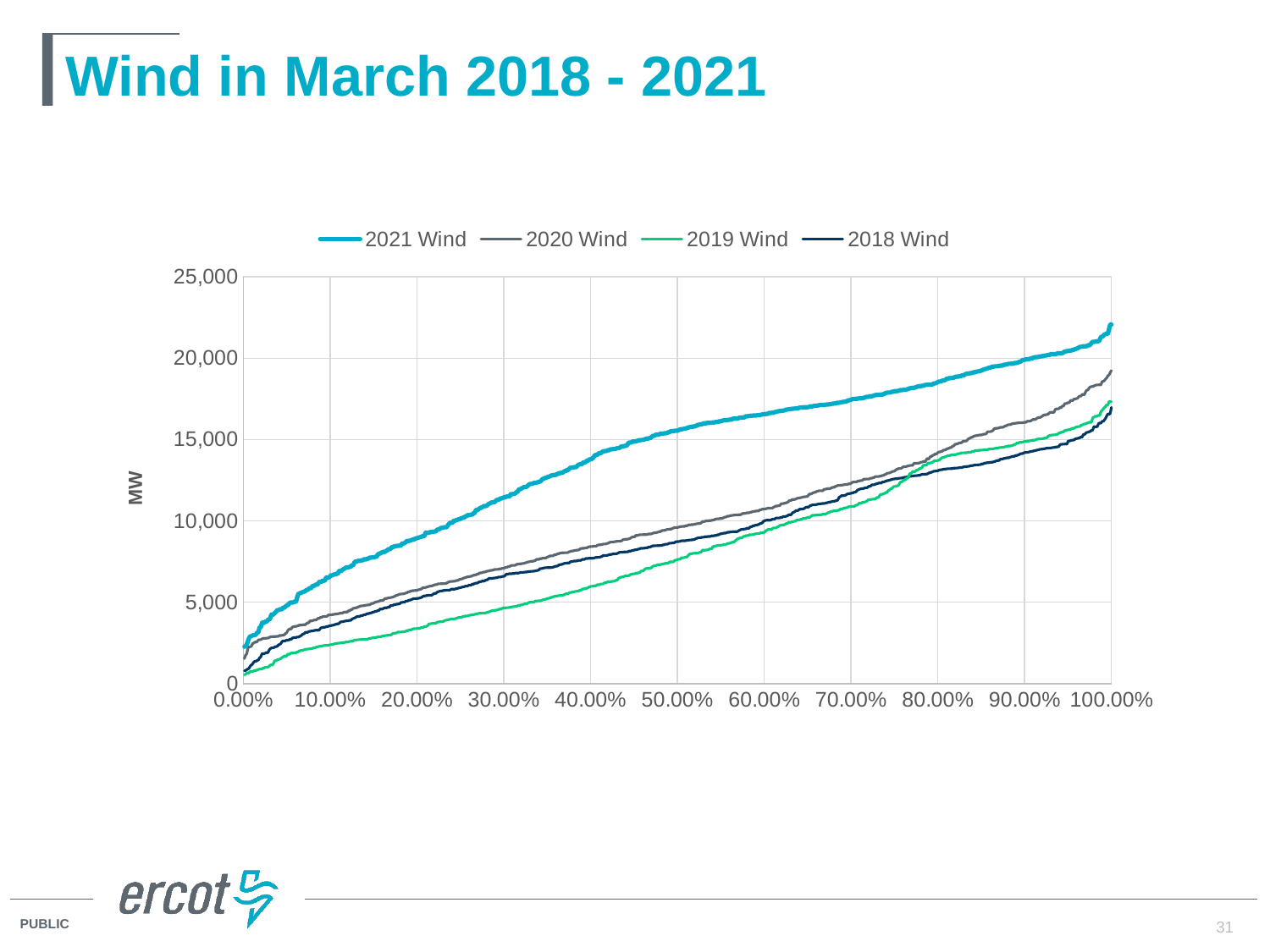
What is the label on the vertical axis? MW Which series has the highest values across the chart? 2021 Wind What is the title of the slide's chart? Wind in March 2018 - 2021 What kind of chart is shown on the slide? Line chart At 20.00% on the x axis, which is larger: 2020 Wind or 2019 Wind? 2020 Wind Is the value for 2019 Wind at 50.00% greater or less than 10,000? less How many series does the legend list? 4 Is the value for 2021 Wind at 50.00% greater or less than 10,000? greater Is the value for 2021 Wind at 100.00% greater or less than 20,000? greater Do the values of the 2021 Wind line rise or fall as you move from 0.00% to 100.00% along the x axis? Rise Which series has the lowest value at 30.00% on the x axis? 2019 Wind At 90.00% on the x axis, which is larger: 2020 Wind or 2018 Wind? 2020 Wind